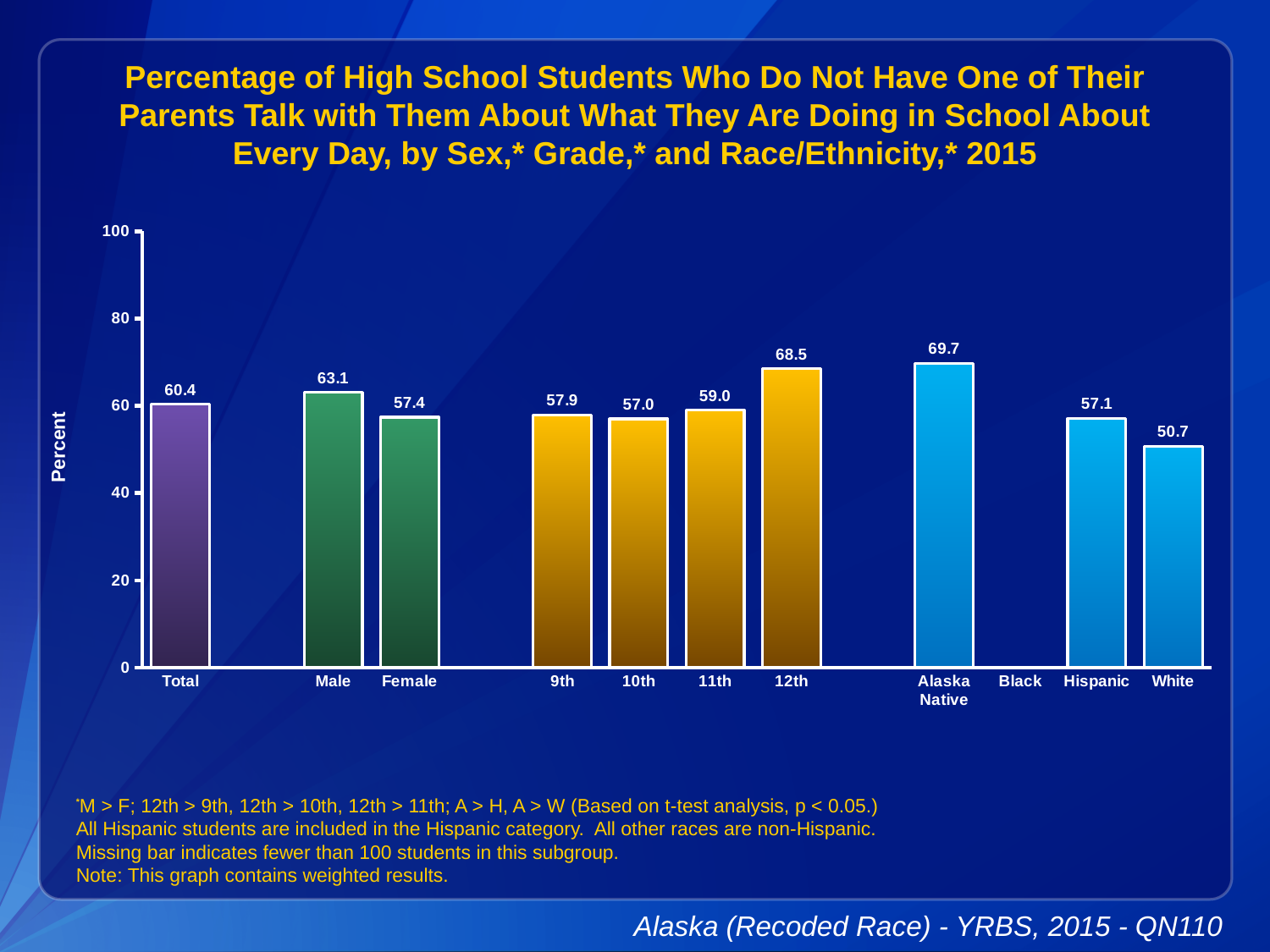
What kind of chart is shown? bar chart Which category label has no bar shown? Black How many bars are plotted on the chart? 10 Which category has the highest value? Alaska Native What is the value for 12th grade? 68.5 What is the value for White? 50.7 Is the value for Hispanic greater or less than 60? less What is the value for Total? 60.4 What is the value for Female? 57.4 Which category has the lowest value? White What is the difference between the Male and Female values? 5.7 Which is larger, the value for 9th grade or 11th grade? 11th